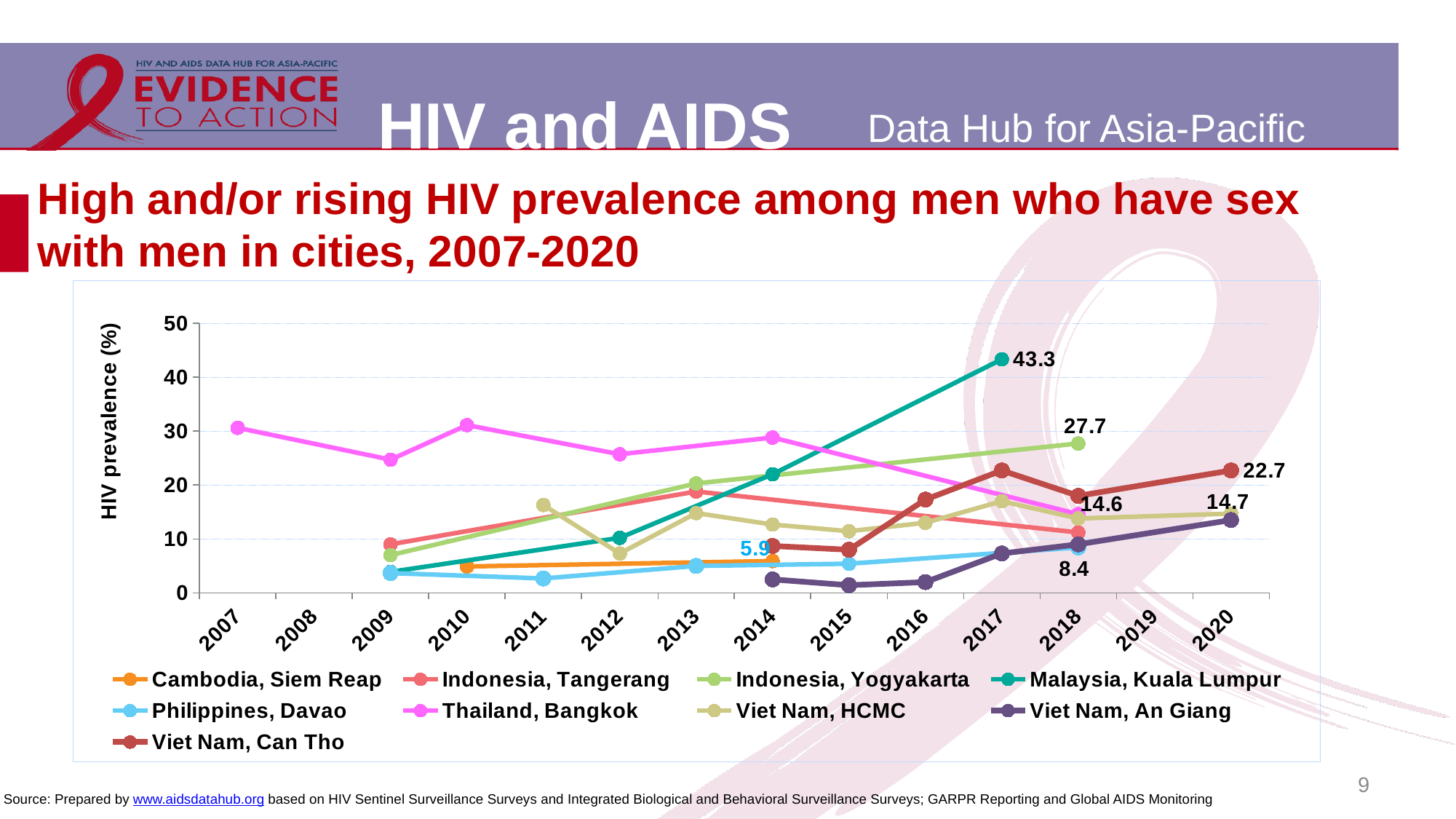
How many series does the legend list? 9 What is the difference between the 2017 value for Malaysia, Kuala Lumpur and the 2018 value for Indonesia, Yogyakarta? 15.6 What kind of chart is shown on the slide? line chart Is the value for Thailand, Bangkok in 2009 greater or less than 20? greater Does the line for Malaysia, Kuala Lumpur rise or fall from 2009 to 2017? rise What is the HIV prevalence for Philippines, Davao in 2018? 8.4 Which is larger: the 2020 value for Viet Nam, Can Tho or the 2018 value for Indonesia, Yogyakarta? Indonesia, Yogyakarta What is the HIV prevalence for Viet Nam, Can Tho in 2020? 22.7 What is the HIV prevalence for Malaysia, Kuala Lumpur in 2017? 43.3 Which city reaches the highest HIV prevalence value on the chart? Malaysia, Kuala Lumpur What is the HIV prevalence for Indonesia, Yogyakarta in 2018? 27.7 How many years are shown on the x axis? 14